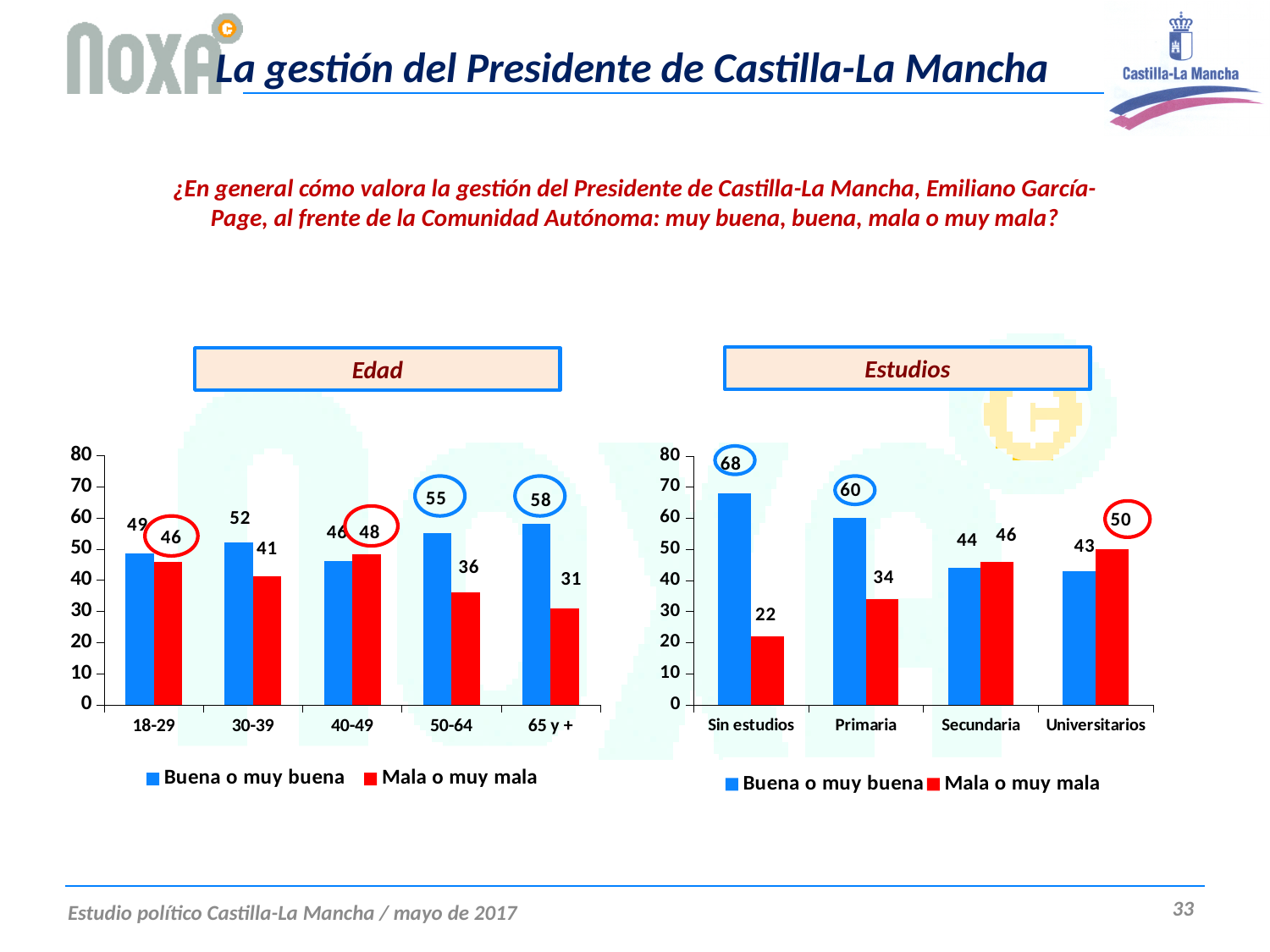
In the Edad chart, which age group has the highest Buena o muy buena value? 65 y + In the Estudios chart, which is larger for Universitarios: Buena o muy buena or Mala o muy mala? Mala o muy mala In the Edad chart, what is the difference between Buena o muy buena and Mala o muy mala for the 50-64 group? 19 In the Edad chart, what is the value of Mala o muy mala for the 30-39 group? 41 In the Estudios chart, how does the Buena o muy buena value change from Sin estudios to Universitarios? It falls In the Edad chart, how many age groups are shown on the x axis? 5 In the Edad chart, what is the value of Buena o muy buena for the 65 y + group? 58 In the Estudios chart, which education group has the highest Mala o muy mala value? Universitarios In the Estudios chart, what is the value of Buena o muy buena for Primaria? 60 In the Estudios chart, what is the value of Mala o muy mala for Sin estudios? 22 In the Edad chart, which age group has the lowest Mala o muy mala value? 65 y + How many series does the legend of the Estudios chart list? 2